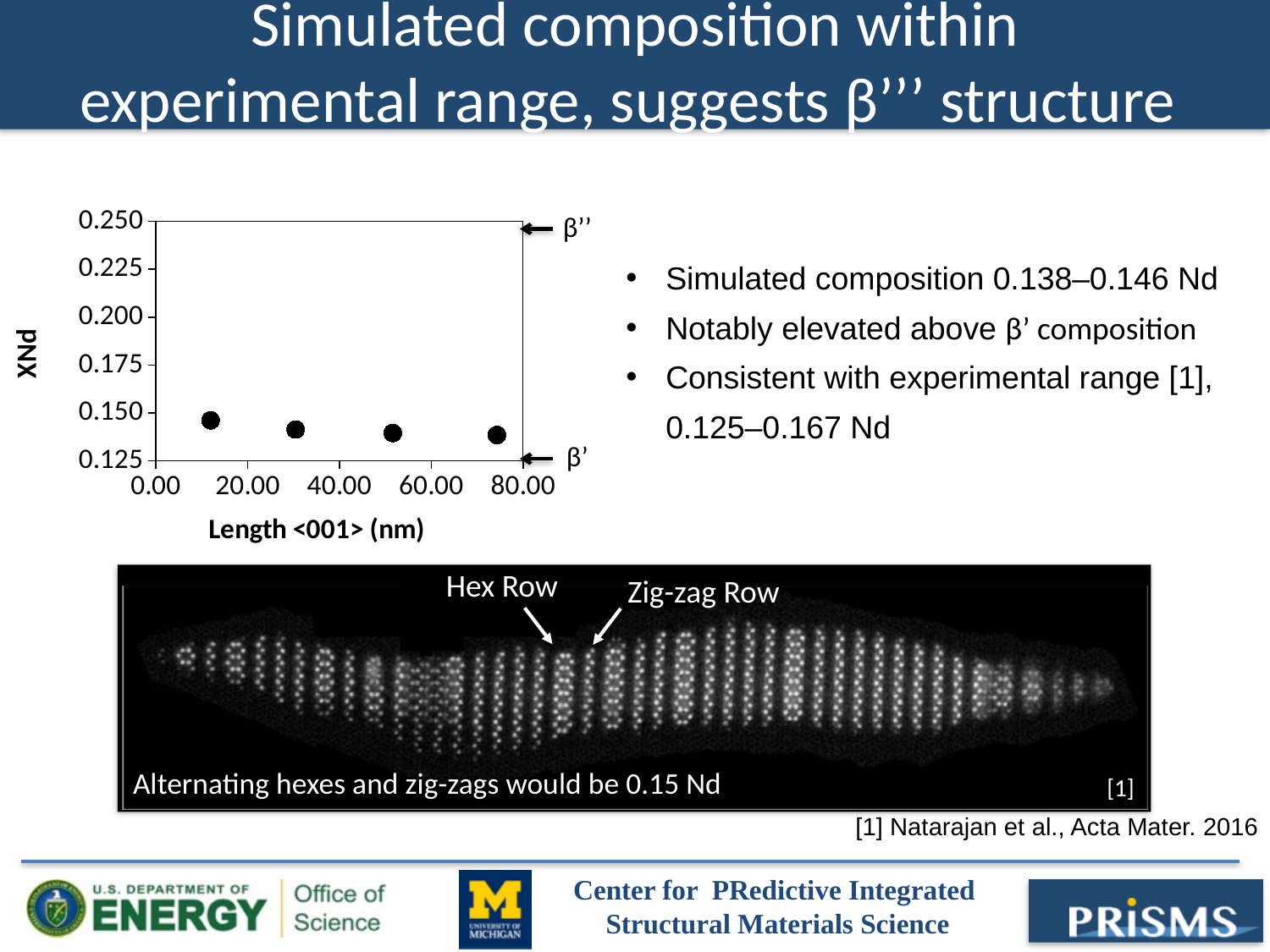
Which data point has the highest XNd value, the leftmost or the rightmost? the leftmost What is the label of the y axis of the chart? XNd What is the label of the x axis of the chart? Length <001> (nm) How many data points are plotted in the chart? 4 Which data point has the highest XNd value in the chart? the leftmost point (near 10 nm) What kind of chart is shown on the slide? scatter plot What is the maximum value shown on the y axis of the chart? 0.250 Is the XNd value of the rightmost data point greater or less than 0.125? greater Do the plotted XNd values rise or fall as Length <001> increases? fall Is the XNd value of the leftmost data point greater or less than 0.175? less Is the XNd value of the rightmost data point greater or less than 0.150? less